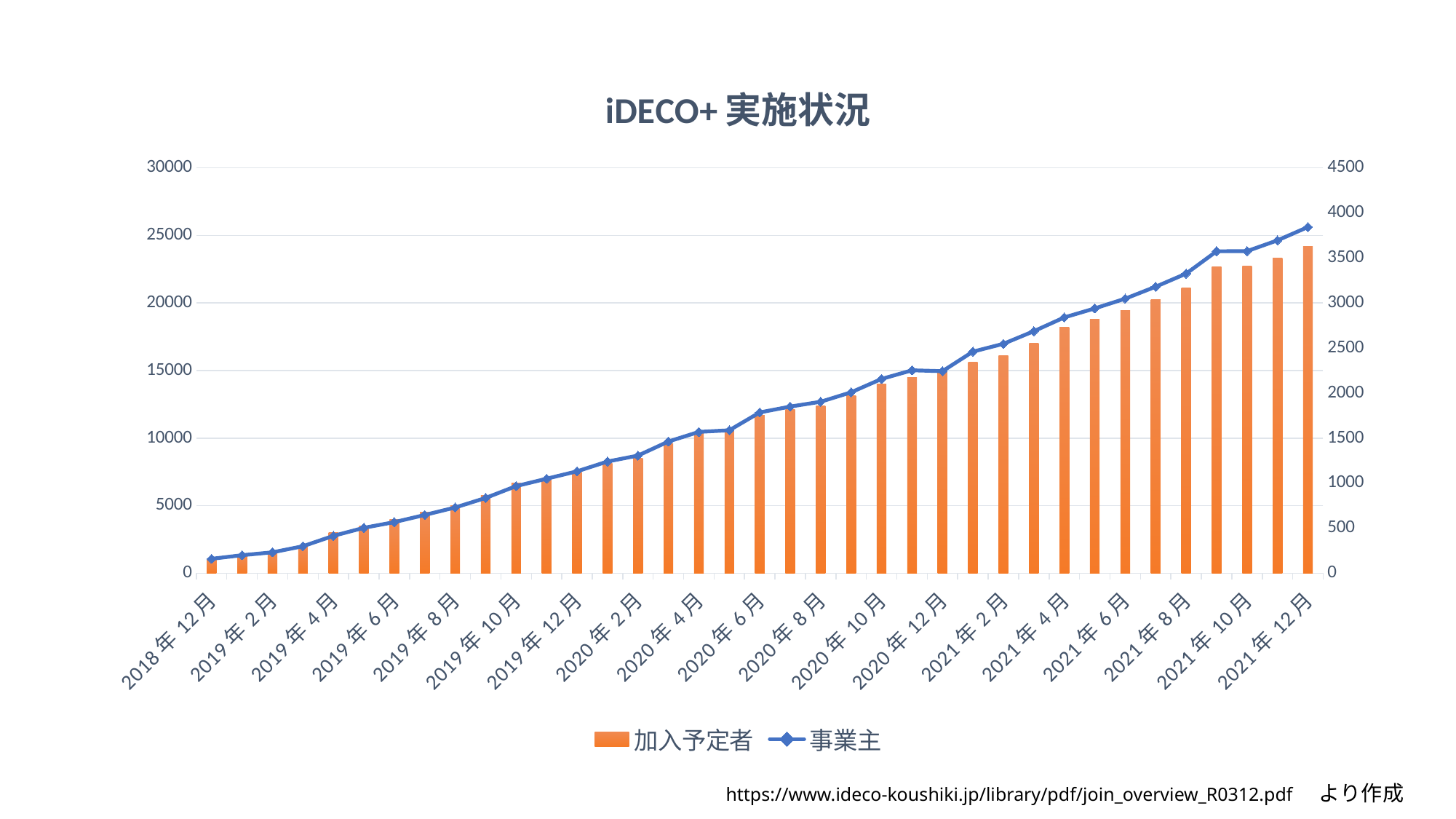
Do the values for 事業主 rise or fall from 2018年12月 to 2021年12月? rise Which month has the highest value for 加入予定者? 2021年12月 Which month has the lowest value for 事業主? 2018年12月 What is the title of the chart? iDECO+ 実施状況 Is the value for 加入予定者 in 2018年12月 greater or less than 5000? less What kind of chart is this? Combination bar and line chart Is the value for 事業主 in 2021年12月 greater or less than 3500 on the right axis? greater Is the value for 加入予定者 in 2020年6月 greater or less than 10000? greater How many series does the legend list? 2 Which series is drawn as bars? 加入予定者 Which is larger, the 加入予定者 value in 2021年12月 or in 2019年12月? 2021年12月